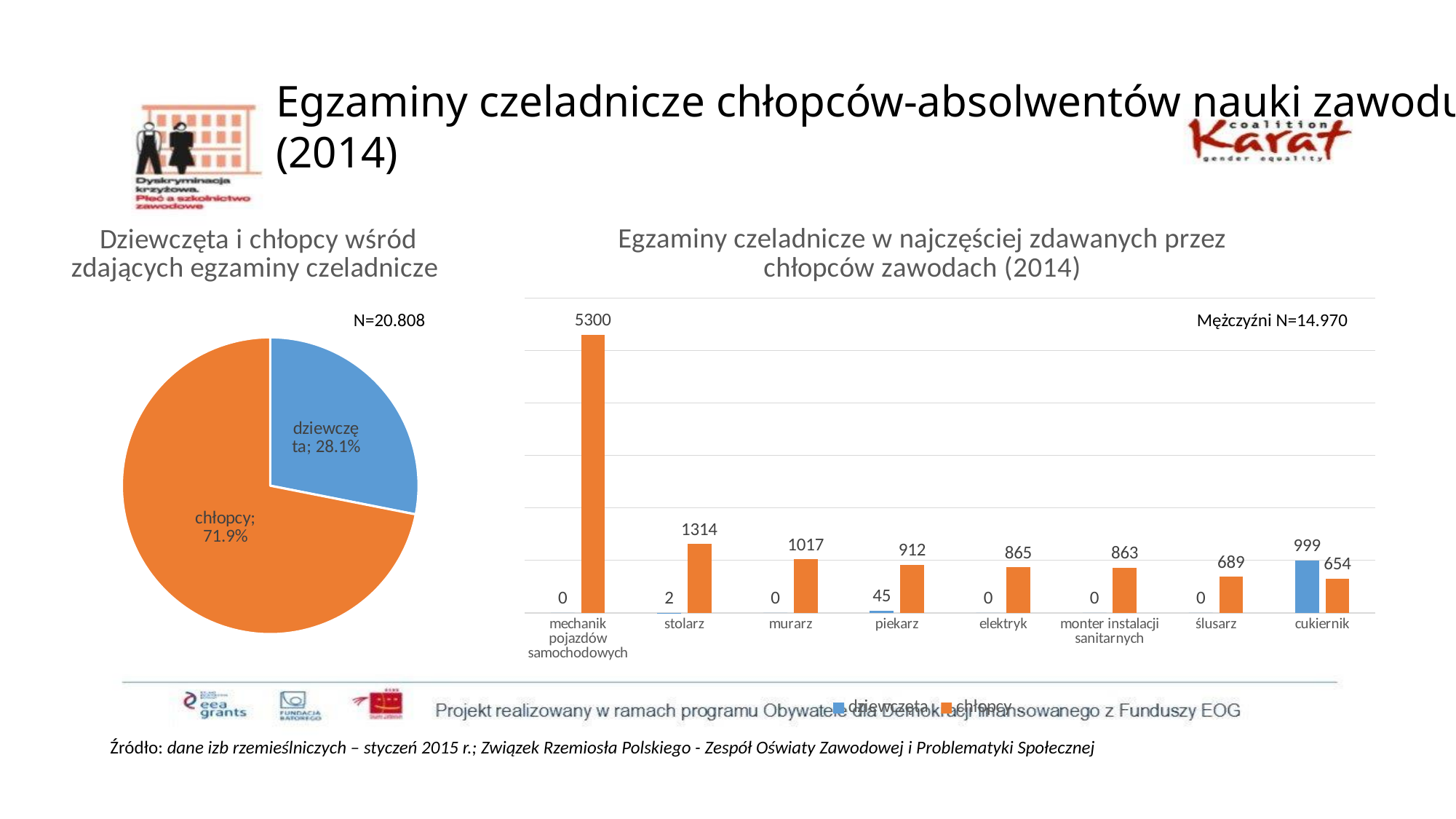
In the bar chart on the right, what is the difference between the chłopcy values for stolarz and murarz? 297 In the bar chart on the right, what is the value for dziewczęta in the category piekarz? 45 In the pie chart on the left, what share of the pie is chłopcy? 71.9% What kind of chart is the chart on the left of the slide? pie chart In the pie chart on the left, what share of the pie is dziewczęta? 28.1% In the bar chart on the right, which category has the highest value for chłopcy? mechanik pojazdów samochodowych In the bar chart on the right, what is the value for dziewczęta in the category cukiernik? 999 In the bar chart on the right, which is larger in the category cukiernik: the value for dziewczęta or for chłopcy? dziewczęta In the bar chart on the right, which category has the lowest value for chłopcy? cukiernik In the bar chart on the right, what is the value for chłopcy in the category mechanik pojazdów samochodowych? 5300 How many series does the legend of the bar chart on the right list? 2 How many categories are shown on the x axis of the bar chart on the right? 8